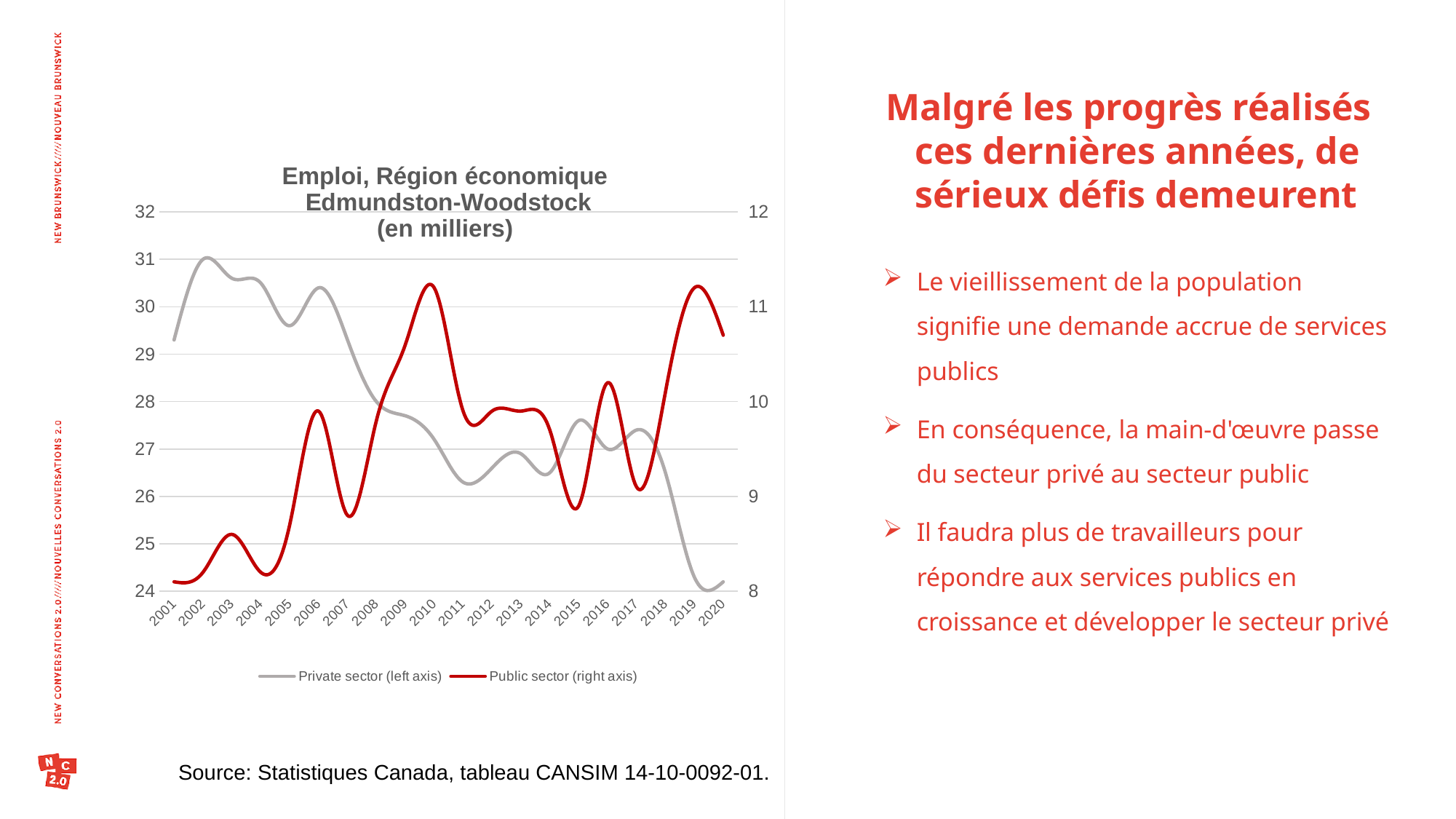
Is the Public sector value for 2001 greater or less than 9? less Does the Private sector series rise or fall overall from 2001 to 2020? fall What kind of chart is shown on the slide? Line chart Is the Private sector value for 2002 greater or less than 30? greater What is the title of the chart? Emploi, Région économique Edmundston-Woodstock (en milliers) Does the Public sector series rise or fall overall from 2001 to 2020? rise How many years are shown on the x axis of the chart? 20 Which series is plotted against the right axis? Public sector Is the Public sector value for 2010 greater or less than 10? greater Which year has the highest Private sector value? 2002 How many series does the chart legend list? 2